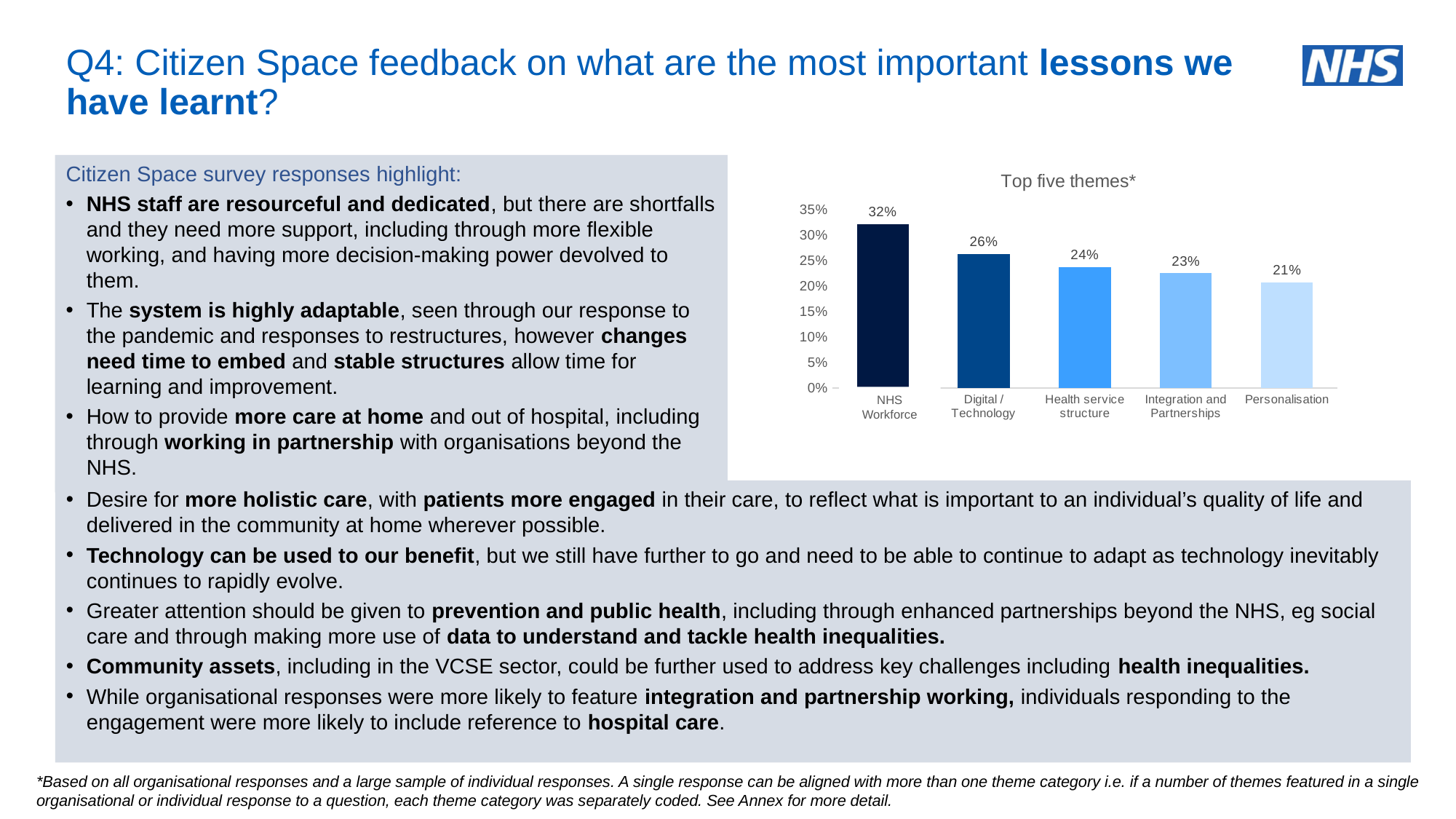
What is the value for Digital / Technology? 26% What kind of chart is shown on the slide? Bar chart Which theme has the lowest value? Personalisation Do the values rise or fall from left to right across the chart? Fall What is the value for Personalisation? 21% What is the difference between the values for Digital / Technology and Health service structure? 2% What is the difference between the values for NHS Workforce and Personalisation? 11% What is the value for NHS Workforce? 32% How many themes are shown in the chart? 5 What is the title of the chart? Top five themes* Which theme has the highest value? NHS Workforce Which is larger, the value for Health service structure or the value for Integration and Partnerships? Health service structure